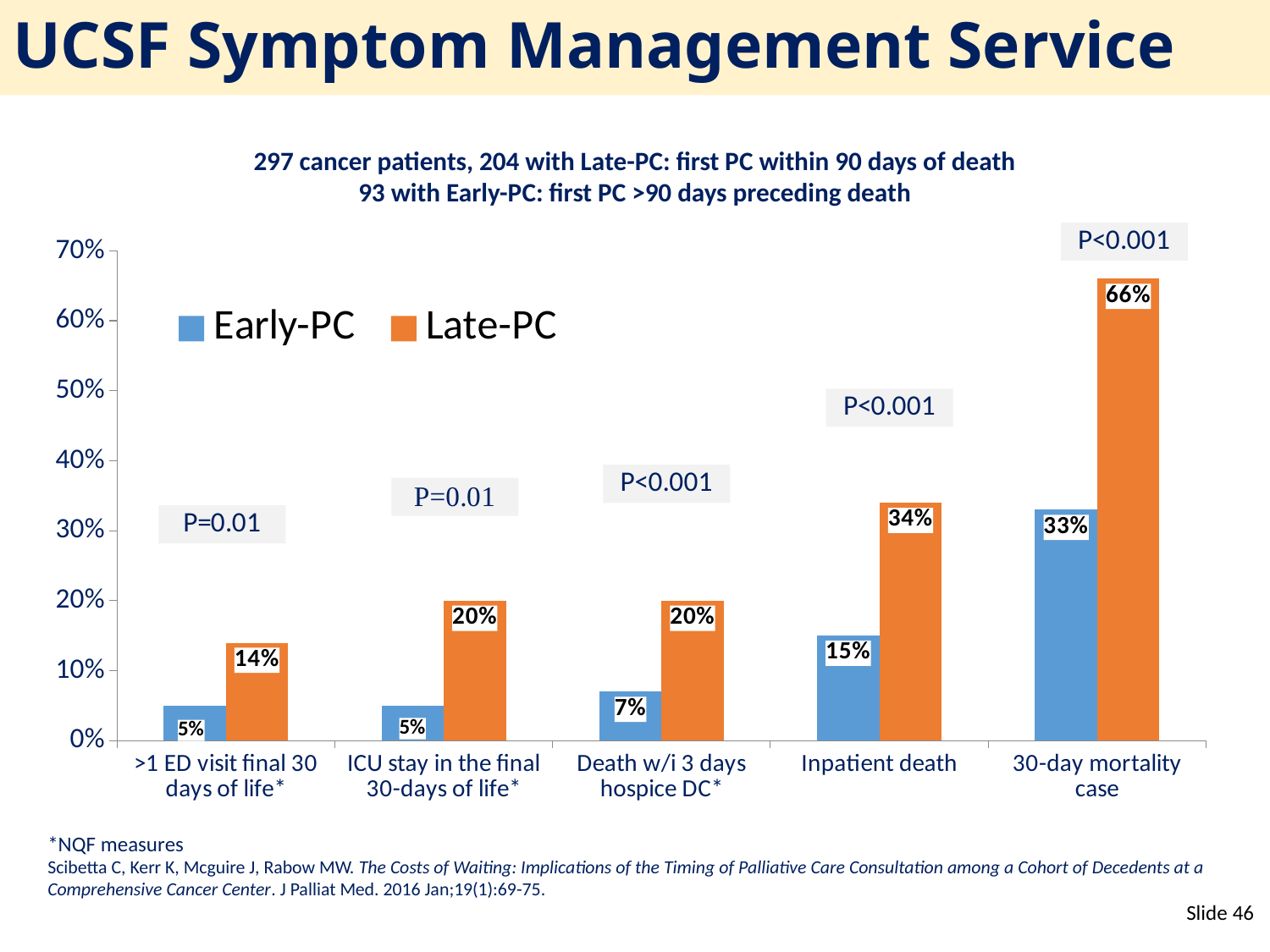
What is the Early-PC value for 30-day mortality case? 33% How many series does the legend list? 2 Which category has the highest Late-PC value? 30-day mortality case Which category has the lowest Late-PC value? >1 ED visit final 30 days of life* How many categories are shown on the x axis? 5 What kind of chart is shown on the slide? bar chart What is the difference between the Late-PC and Early-PC values for 30-day mortality case? 33% What is the Late-PC value for Inpatient death? 34% What is the difference between the Late-PC and Early-PC values for Inpatient death? 19% Is the Late-PC value for 30-day mortality case greater or less than 60%? greater Which is larger for ICU stay in the final 30-days of life*: the Early-PC value or the Late-PC value? Late-PC What is the Early-PC value for Death w/i 3 days hospice DC*? 7%